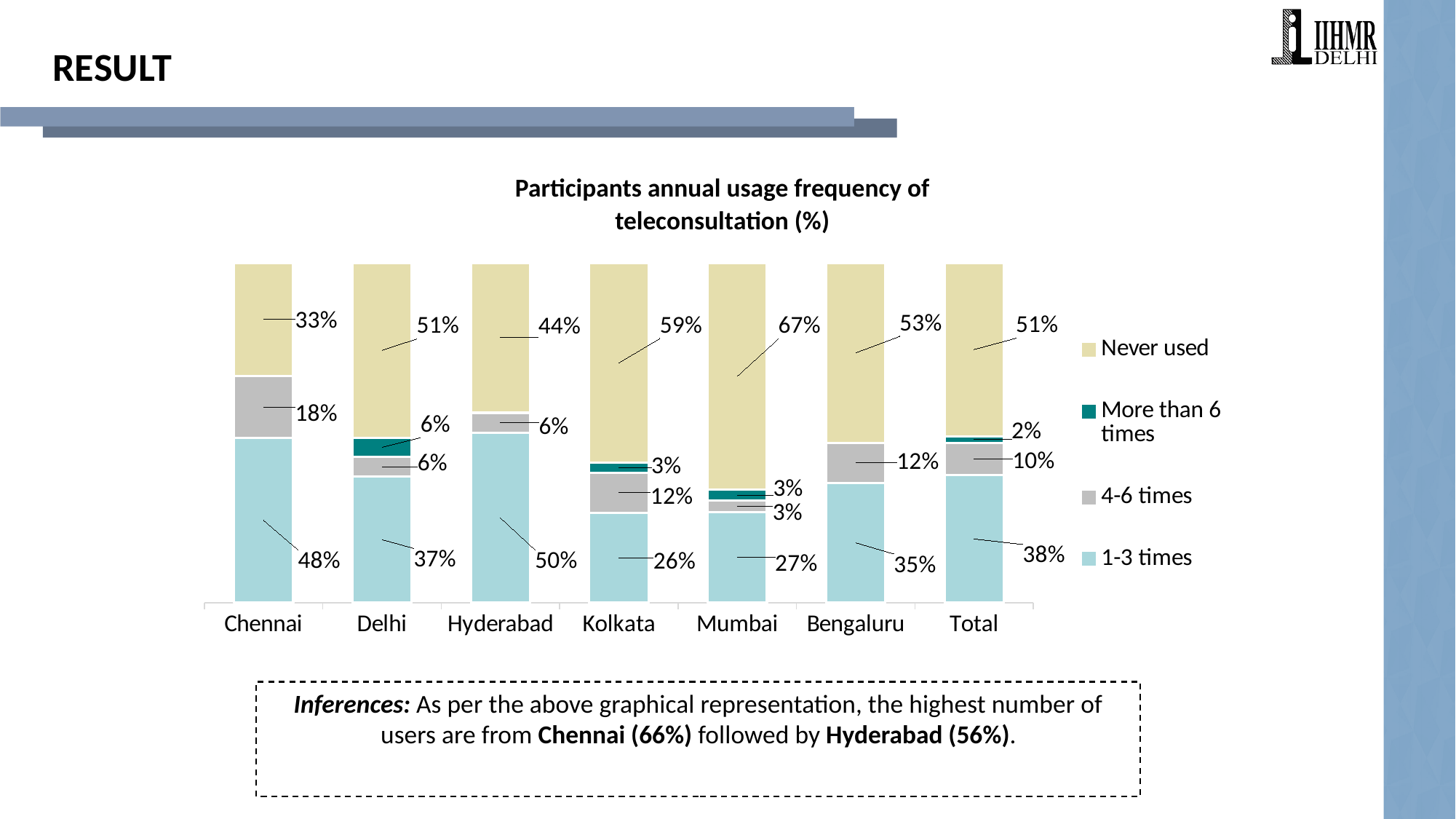
Which city has the lowest '1-3 times' percentage? Kolkata What kind of chart is shown on the slide? Stacked bar chart What percentage of participants in Kolkata used teleconsultation 4-6 times? 12% What is the title of the chart? Participants annual usage frequency of teleconsultation (%) What is the difference between the 'Never used' percentages for Mumbai and Chennai? 34 percentage points Which is larger, the '1-3 times' value for Hyderabad or for Delhi? Hyderabad How many series does the legend list? 4 Which city has the highest 'Never used' percentage? Mumbai How many categories are shown on the x axis? 7 What is the 'More than 6 times' value for the Total bar? 2% What percentage of participants in Chennai used teleconsultation 1-3 times? 48% What is the 'Never used' value for Mumbai? 67%